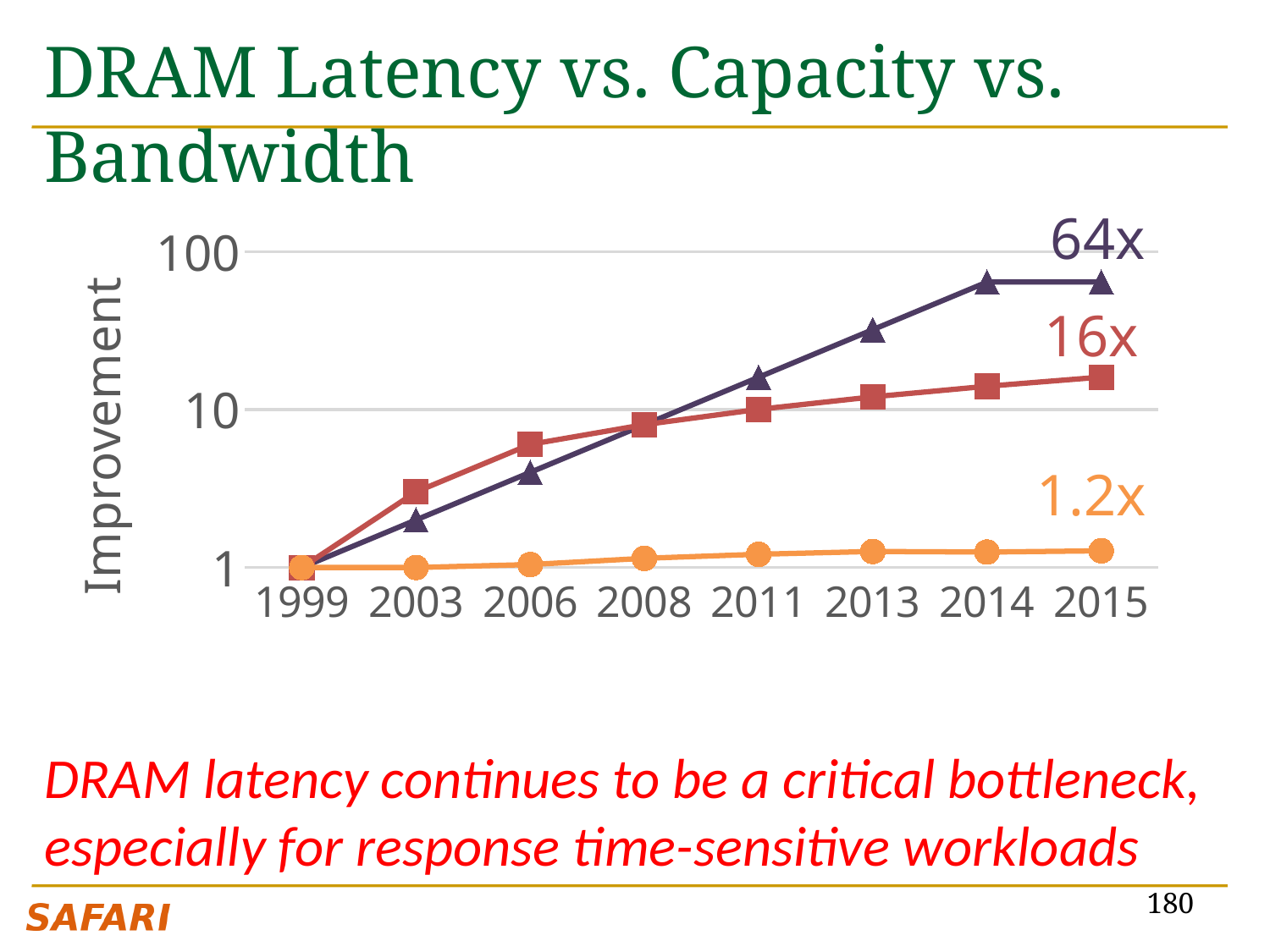
How many years are marked along the x axis of the chart? 8 Does the purple triangle line rise or fall from 1999 to 2015? rise Which line has the lowest improvement value in 2015? the orange circle line What improvement value is labelled at the end of the orange circle line in 2015? 1.2x What improvement value is labelled at the end of the purple triangle line in 2015? 64x What kind of chart is shown on the slide? line chart Is the value of the red square line in 2006 greater or less than 10? less Which line has the highest improvement value in 2015? the purple triangle line What is the label on the y axis of the chart? Improvement What improvement value is labelled at the end of the red square line in 2015? 16x Is the value of the purple triangle line in 2013 greater or less than 10? greater In 2006, which line is higher: the red square line or the purple triangle line? the red square line